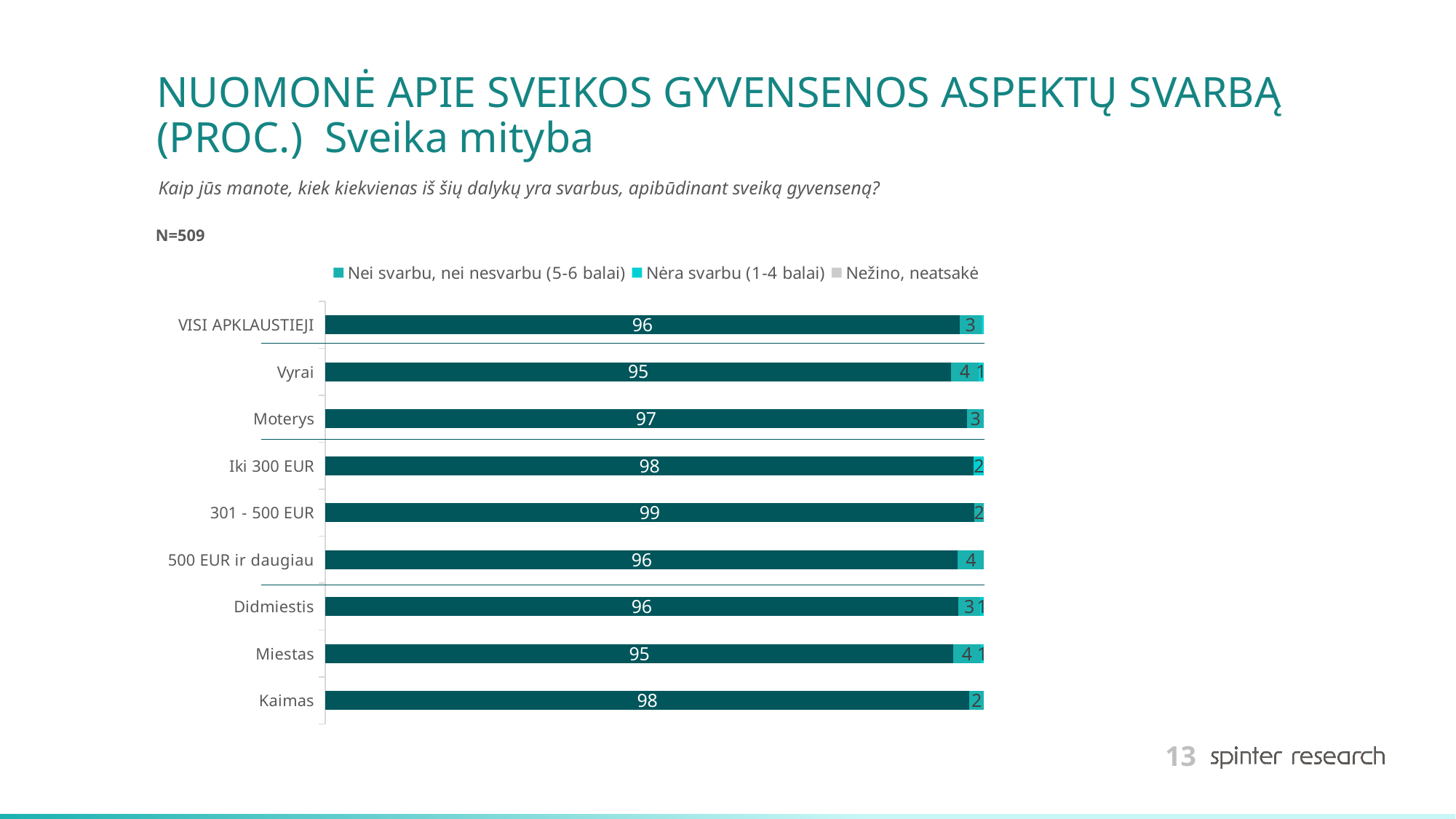
What is the value of the dark teal segment for "301 - 500 EUR"? 99 How many categories (rows) are plotted in the chart? 9 Which category has the highest dark teal value? 301 - 500 EUR Which has a larger dark teal value, "Iki 300 EUR" or "500 EUR ir daugiau"? Iki 300 EUR What is the total of the stacked bar for "Vyrai"? 100 What is the difference between the dark teal values for "Moterys" and "Vyrai"? 2 What sample size (N) is stated on the slide? N=509 What kind of chart is shown on the slide? bar chart What is the value of the light teal segment for "500 EUR ir daugiau"? 4 How many series does the chart legend list? 3 What is the value of the dark teal segment for "Kaimas"? 98 Among the income groups (Iki 300 EUR, 301 - 500 EUR, 500 EUR ir daugiau), which has the lowest dark teal value? 500 EUR ir daugiau